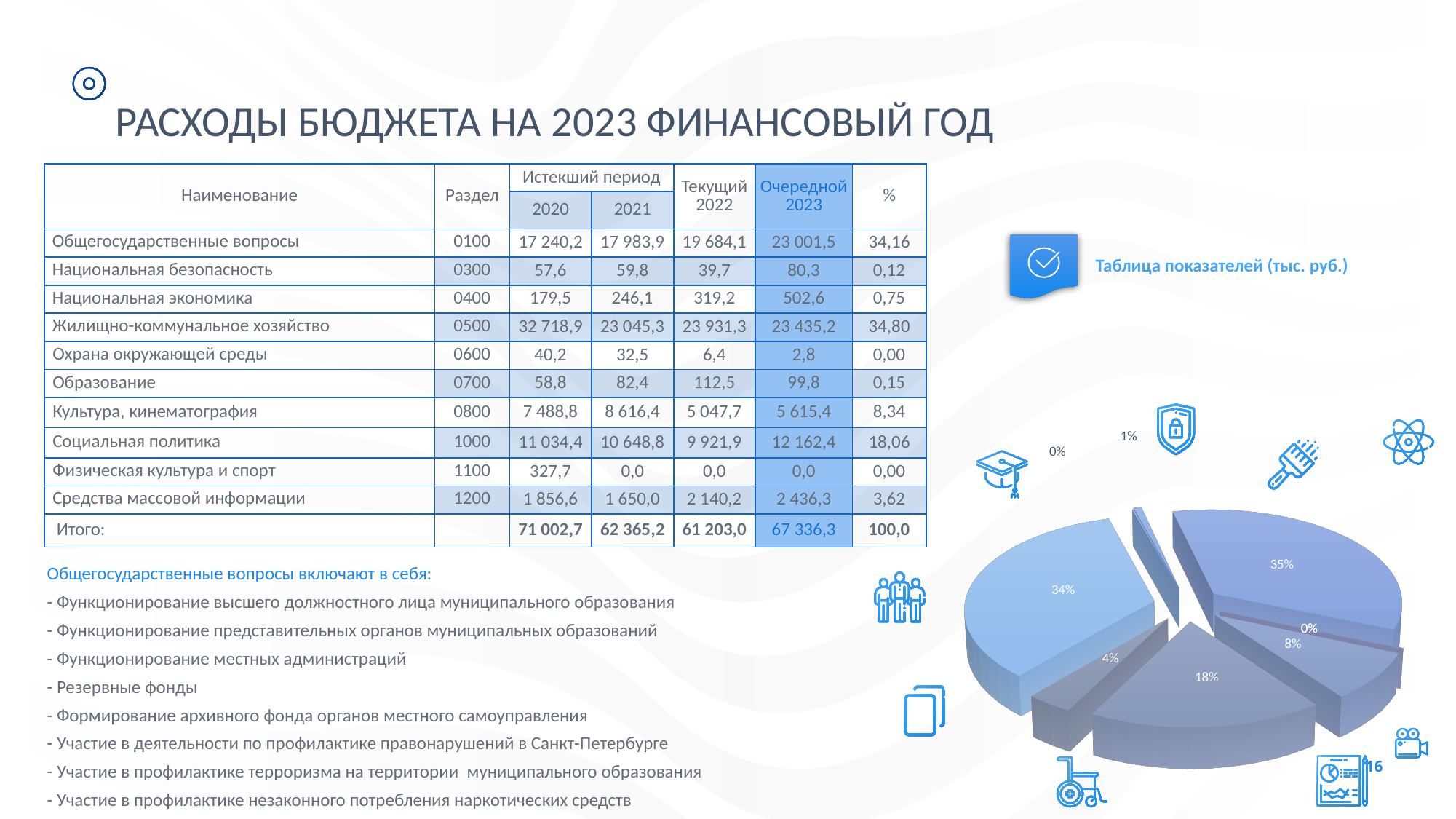
Is the pie chart drawn in 3D? Yes What kind of chart is shown on the right side of the slide? pie chart Does the pie chart have a legend? No Which is larger on the pie chart, the slice labeled 34% or the slice labeled 35%? 35% What is the smallest percentage label shown on the pie chart? 0% What is the difference between the 35% slice and the 18% slice on the pie chart? 17% What is the largest percentage label shown on the pie chart? 35% What is the combined share of the two largest slices (35% and 34%) on the pie chart? 69% Which is larger on the pie chart, the slice labeled 8% or the slice labeled 4%? 8%